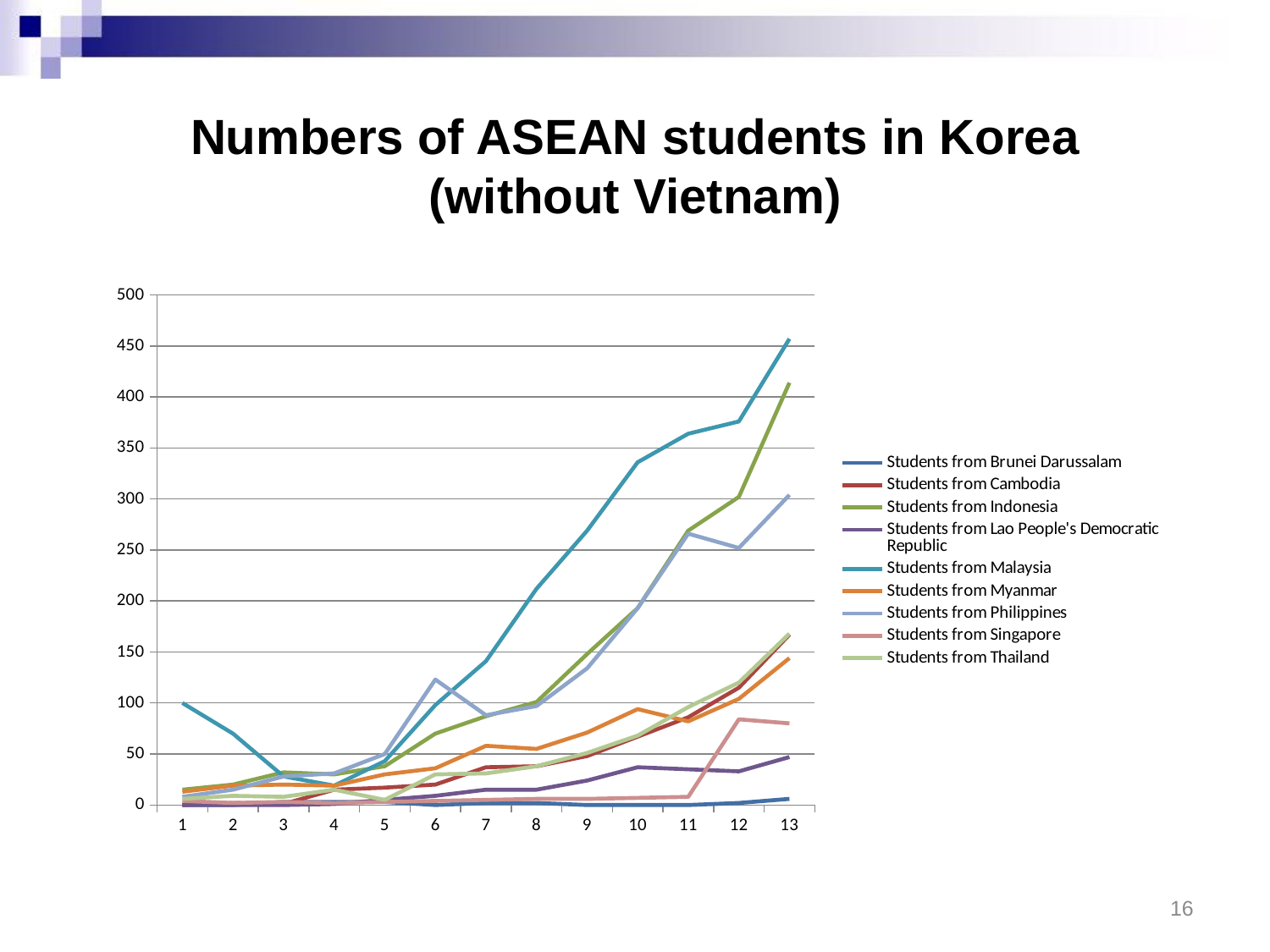
Do the values for Students from Indonesia rise or fall from point 6 to point 13? rise What is the title of the chart? Numbers of ASEAN students in Korea (without Vietnam) How many series does the legend list? 9 Is the value for Students from Malaysia at point 13 greater or less than 400? greater At point 13, which is larger: Students from Malaysia or Students from Indonesia? Students from Malaysia Is the value for Students from Singapore at point 12 greater or less than 50? greater Which series has the highest value at point 13? Students from Malaysia How many points are there along the x axis? 13 Is the value for Students from Brunei Darussalam at point 13 greater or less than 50? less Which series has the lowest value at point 13? Students from Brunei Darussalam What kind of chart is shown on the slide? line chart